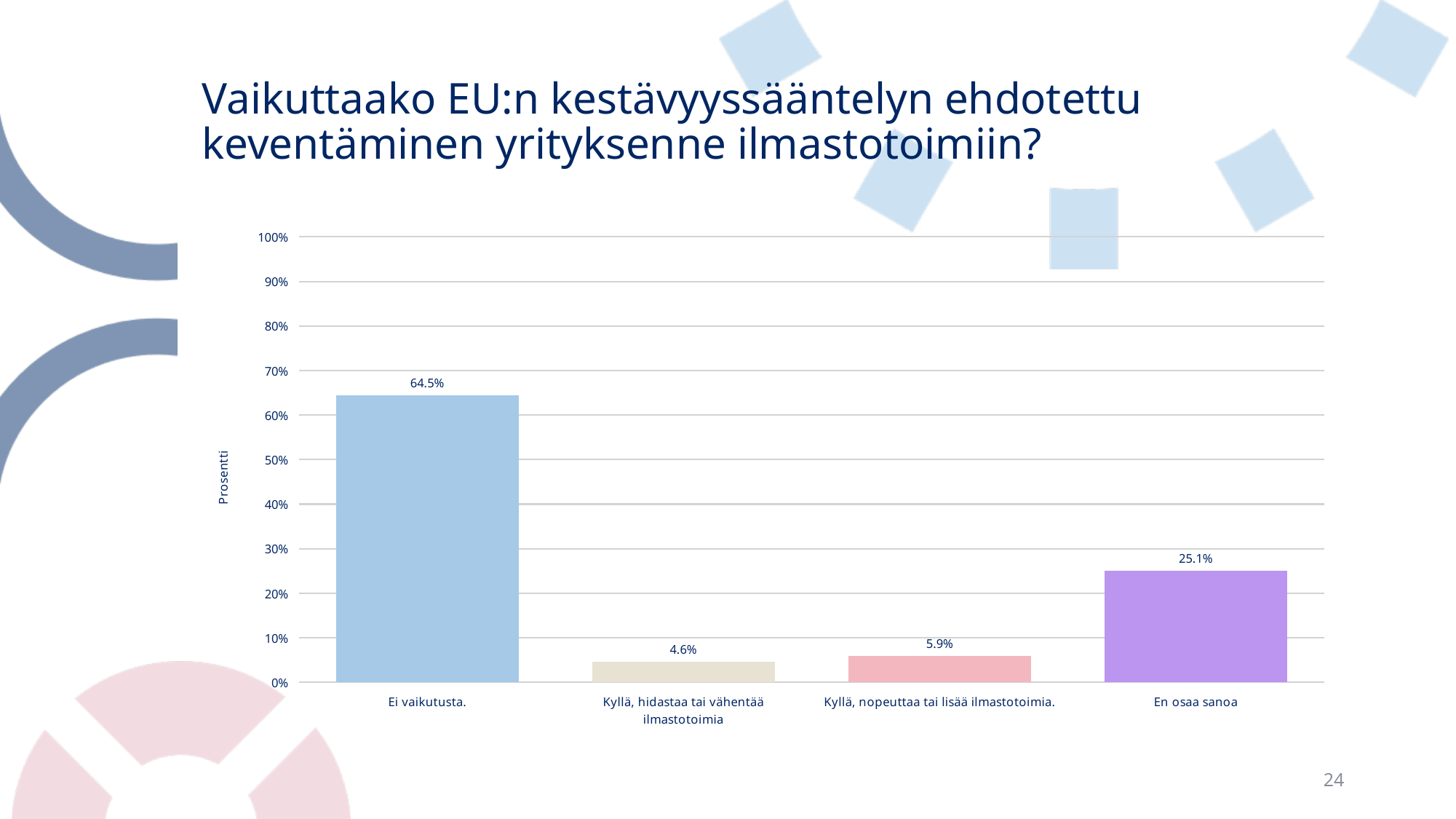
What is the label of the vertical axis? Prosentti Which category has the highest value? Ei vaikutusta. Is the value for "En osaa sanoa" greater or less than 30%? less How many categories are shown on the chart? 4 What is the value for "Kyllä, nopeuttaa tai lisää ilmastotoimia."? 5.9% What is the difference between the values for "Ei vaikutusta." and "En osaa sanoa"? 39.4% Which is larger, the value for "Kyllä, nopeuttaa tai lisää ilmastotoimia." or "Kyllä, hidastaa tai vähentää ilmastotoimia"? Kyllä, nopeuttaa tai lisää ilmastotoimia. What is the value for "En osaa sanoa"? 25.1% What is the value for "Kyllä, hidastaa tai vähentää ilmastotoimia"? 4.6% What kind of chart is shown on the slide? bar chart What is the value for "Ei vaikutusta."? 64.5% Which category has the lowest value? Kyllä, hidastaa tai vähentää ilmastotoimia